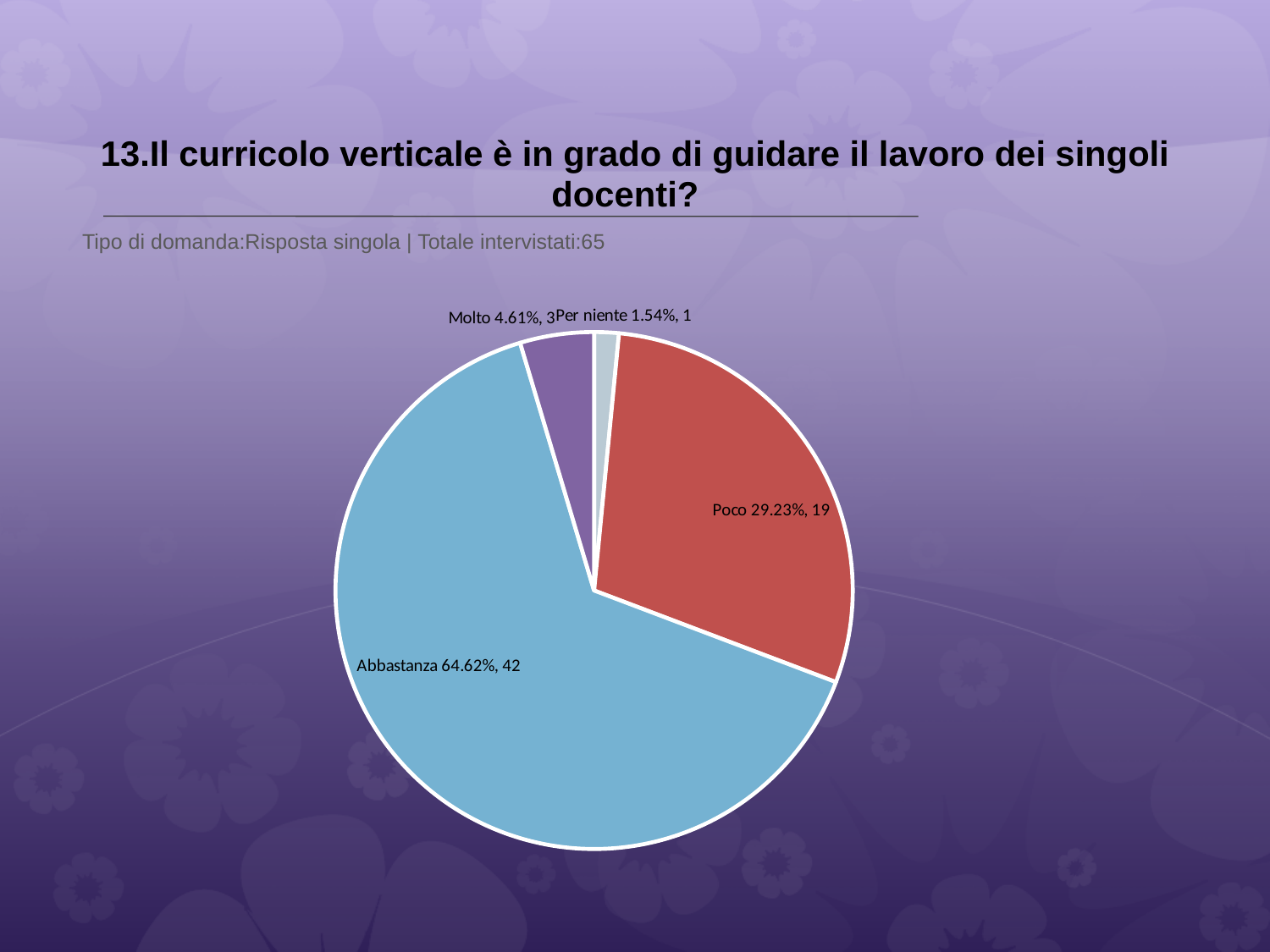
How many more respondents answered "Abbastanza" than "Poco"? 23 How many slices does the pie chart have? 4 What percentage of respondents answered "Abbastanza"? 64.62% What is the total number of respondents stated on the slide? 65 What colour is the "Poco" slice? red How many respondents answered "Poco"? 19 Which received more responses, "Molto" or "Per niente"? Molto What percentage of respondents answered "Molto"? 4.61% Which response has the smallest share of the pie? Per niente What kind of chart is shown on the slide? pie chart How many respondents answered "Per niente"? 1 Which response has the largest share of the pie? Abbastanza